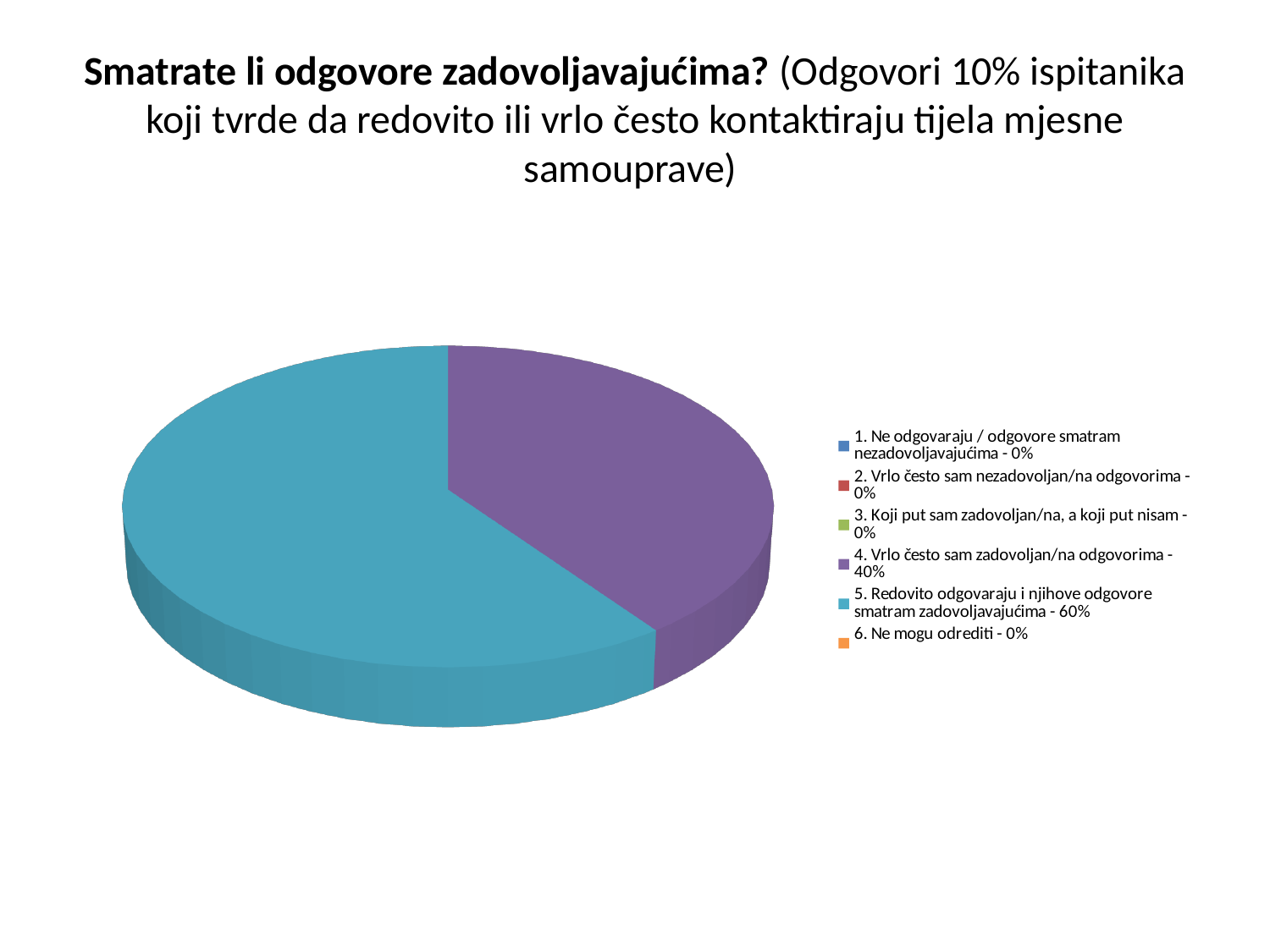
What colour is the slice for "4. Vrlo često sam zadovoljan/na odgovorima"? purple How many categories have a share of 0%? 4 Which category has the largest share of the pie? 5. Redovito odgovaraju i njihove odgovore smatram zadovoljavajućima What percentage is shown for "6. Ne mogu odrediti"? 0% What share of the pie does "5. Redovito odgovaraju i njihove odgovore smatram zadovoljavajućima" have? 60% What share of the pie does "4. Vrlo često sam zadovoljan/na odgovorima" have? 40% What is the difference between the shares of category 5 and category 4? 20% What percentage is shown for "1. Ne odgovaraju / odgovore smatram nezadovoljavajućima"? 0% How many entries does the legend list? 6 What kind of chart is shown on the slide? pie chart What colour is the slice for "5. Redovito odgovaraju i njihove odgovore smatram zadovoljavajućima"? teal Which is larger, the share for category 4 or the share for category 5? category 5